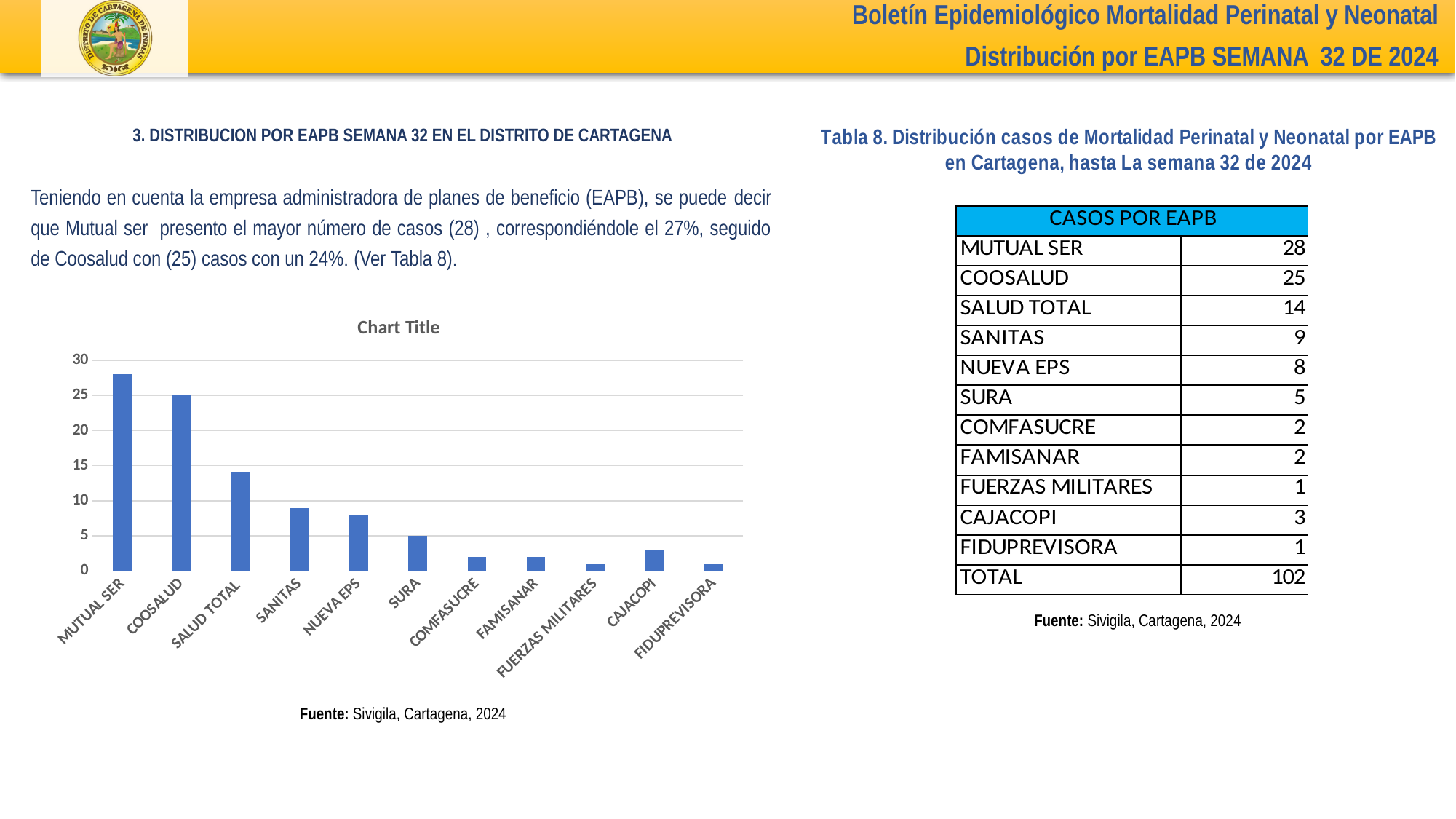
Is the value for NUEVA EPS greater or less than 10? less How many EAPB categories are plotted on the x axis of the chart? 11 Is the value for SALUD TOTAL greater or less than 10? greater What is the difference between the values for MUTUAL SER and COOSALUD? 3 What is the title shown above the chart? Chart Title Which is larger in the chart, the value for SANITAS or the value for CAJACOPI? SANITAS What kind of chart is shown on the slide? bar chart Which EAPB has the highest bar in the chart? MUTUAL SER What is the value for SURA in the chart? 5 What is the value for COOSALUD in the chart? 25 Do the bar values generally rise or fall from MUTUAL SER to SURA along the x axis? fall What is the value for MUTUAL SER in the chart? 28